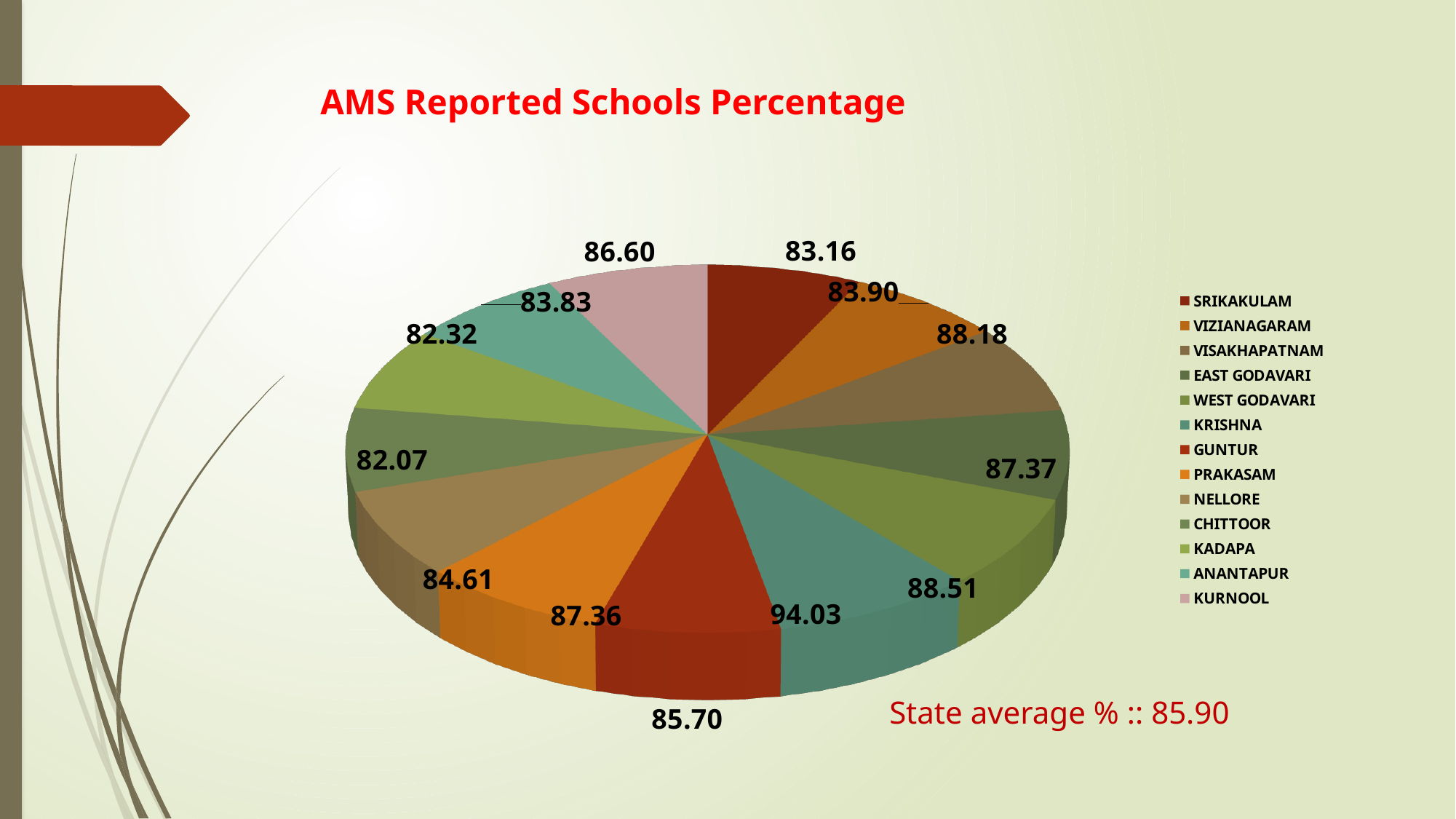
Which has a larger value, WEST GODAVARI or NELLORE? WEST GODAVARI What is the value shown for GUNTUR? 85.70 Which district has the lowest value in the pie chart? CHITTOOR What state average percentage is stated on the slide? 85.90 What is the difference between the values for KRISHNA and CHITTOOR? 11.96 What is the value shown for SRIKAKULAM? 83.16 How many districts (slices) does the pie chart show? 13 What is the value shown for KURNOOL? 86.60 Which district has the highest value in the pie chart? KRISHNA What is the value shown for KRISHNA? 94.03 What is the title of the chart? AMS Reported Schools Percentage What type of chart is shown on the slide? pie chart